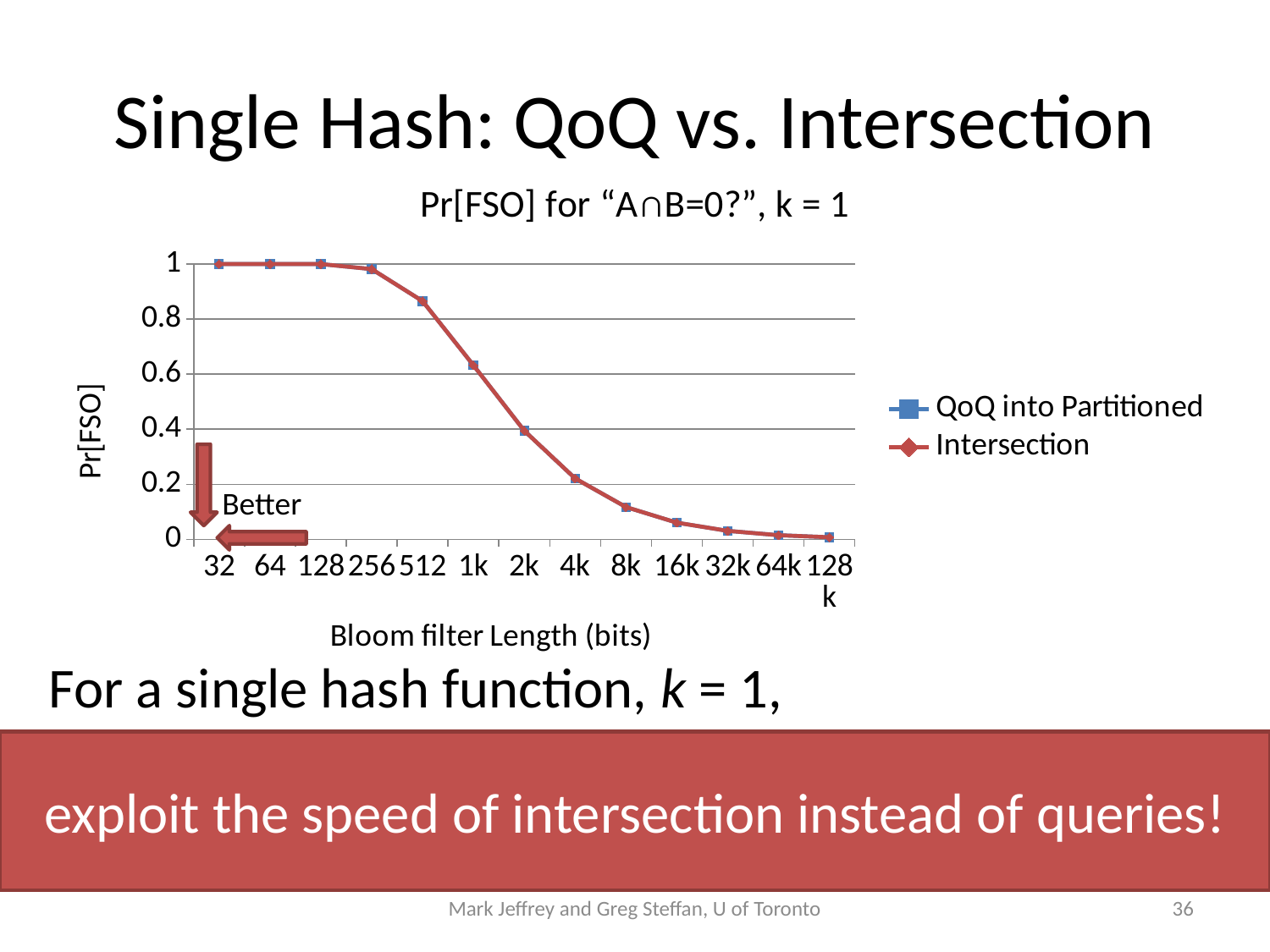
Is the Pr[FSO] value for QoQ into Partitioned at 1k bits greater or less than 0.4? greater Is the Pr[FSO] value for Intersection at 512 bits greater or less than 0.8? greater What kind of chart is shown on the slide? line chart What is the label of the x axis? Bloom filter Length (bits) Is the Pr[FSO] value for Intersection at 4k bits greater or less than 0.4? less How many Bloom filter lengths are plotted along the x axis? 13 How many series does the legend list? 2 What is the title of the chart? Pr[FSO] for "A∩B=0?", k = 1 Which is larger for the Intersection series: the Pr[FSO] value at 512 bits or at 2k bits? 512 bits What is the Pr[FSO] value for the Intersection series at a Bloom filter length of 32 bits? 1 Do the plotted values rise or fall as the Bloom filter length increases? fall